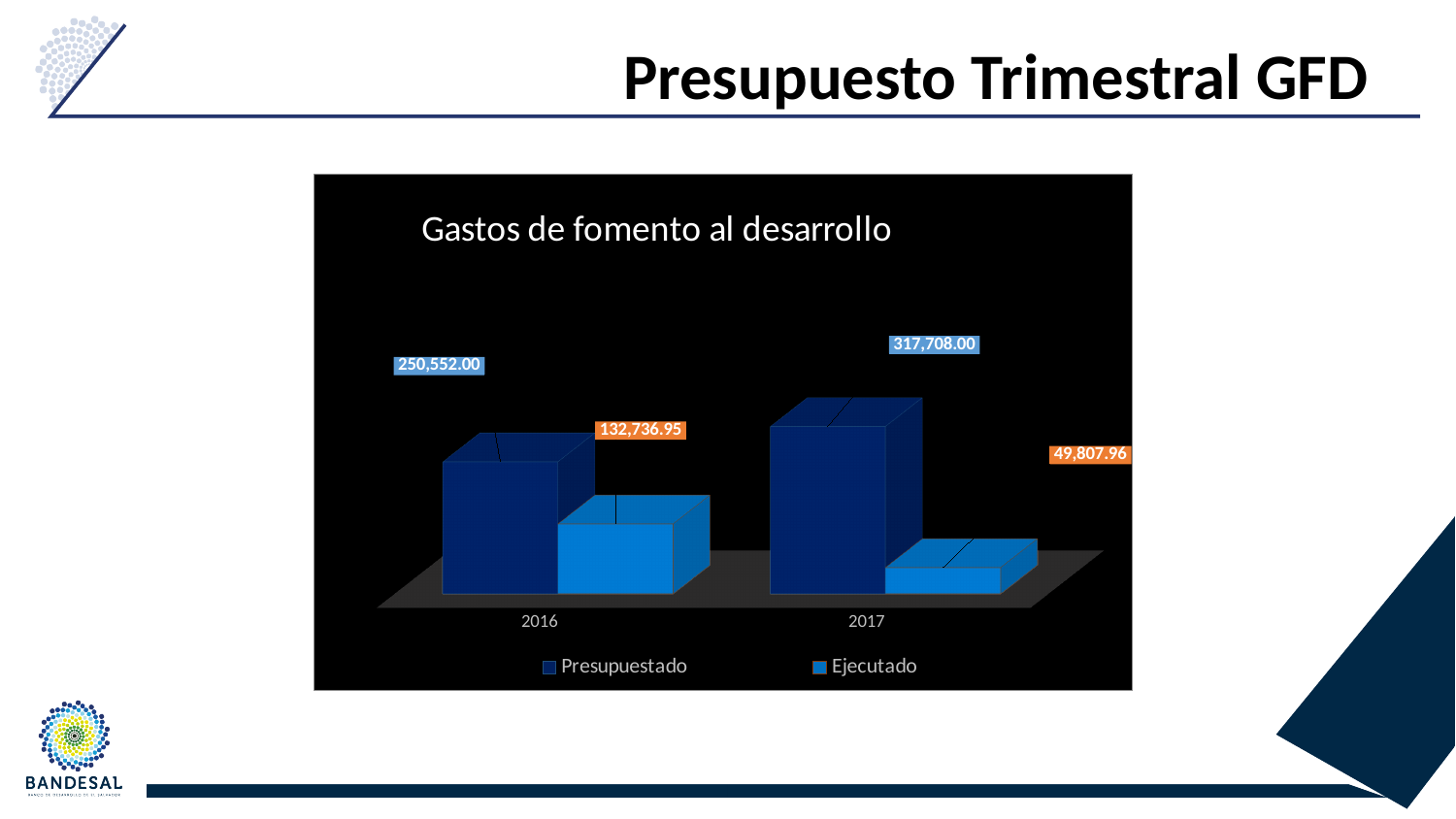
What is the Presupuestado value for 2016? 250,552.00 How many years are shown on the x axis? 2 What is the difference between the Presupuestado and Ejecutado values for 2016? 117,815.05 Is the Ejecutado value for 2016 larger or smaller than the Ejecutado value for 2017? larger Which year has the higher Presupuestado value? 2017 What is the Ejecutado value for 2016? 132,736.95 What is the Ejecutado value for 2017? 49,807.96 Which year has the lower Ejecutado value? 2017 What is the Presupuestado value for 2017? 317,708.00 What is the difference between the Presupuestado values for 2017 and 2016? 67,156.00 How many series does the legend list? 2 What type of chart is shown on the slide? bar chart